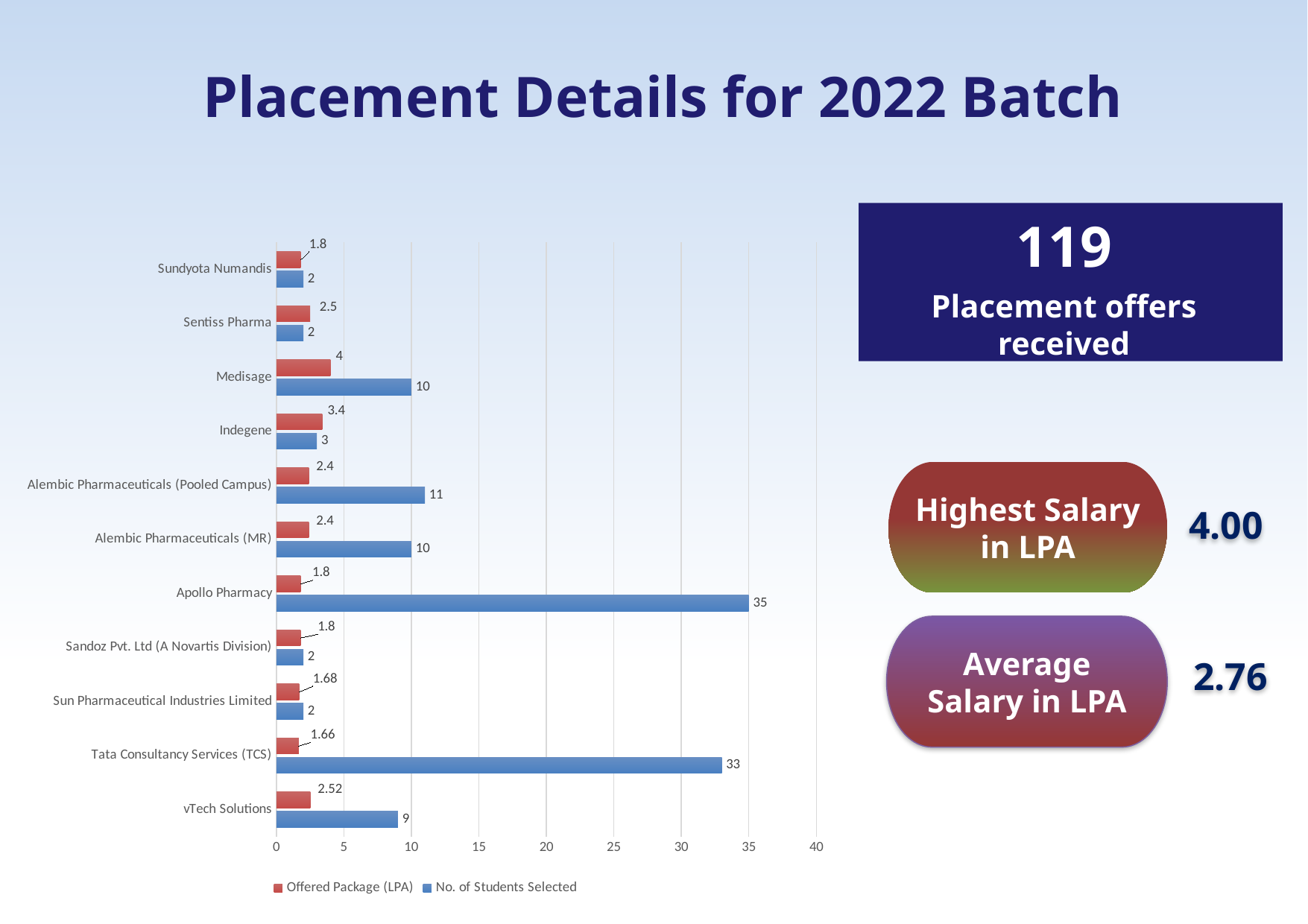
Which colour represents the No. of Students Selected series? Blue Which company selected the highest number of students? Apollo Pharmacy Which has a higher offered package (LPA): Indegene or Sentiss Pharma? Indegene How many students were selected by vTech Solutions? 9 How many series does the chart legend list? 2 Which company has the lowest offered package (LPA)? Tata Consultancy Services (TCS) What is the difference in the number of students selected between Apollo Pharmacy and Tata Consultancy Services (TCS)? 2 What type of chart is shown on the slide? Bar chart What is the offered package (LPA) for Tata Consultancy Services (TCS)? 1.66 How many companies are listed in the chart? 11 What is the offered package (LPA) for Medisage? 4 How many students were selected by Apollo Pharmacy? 35